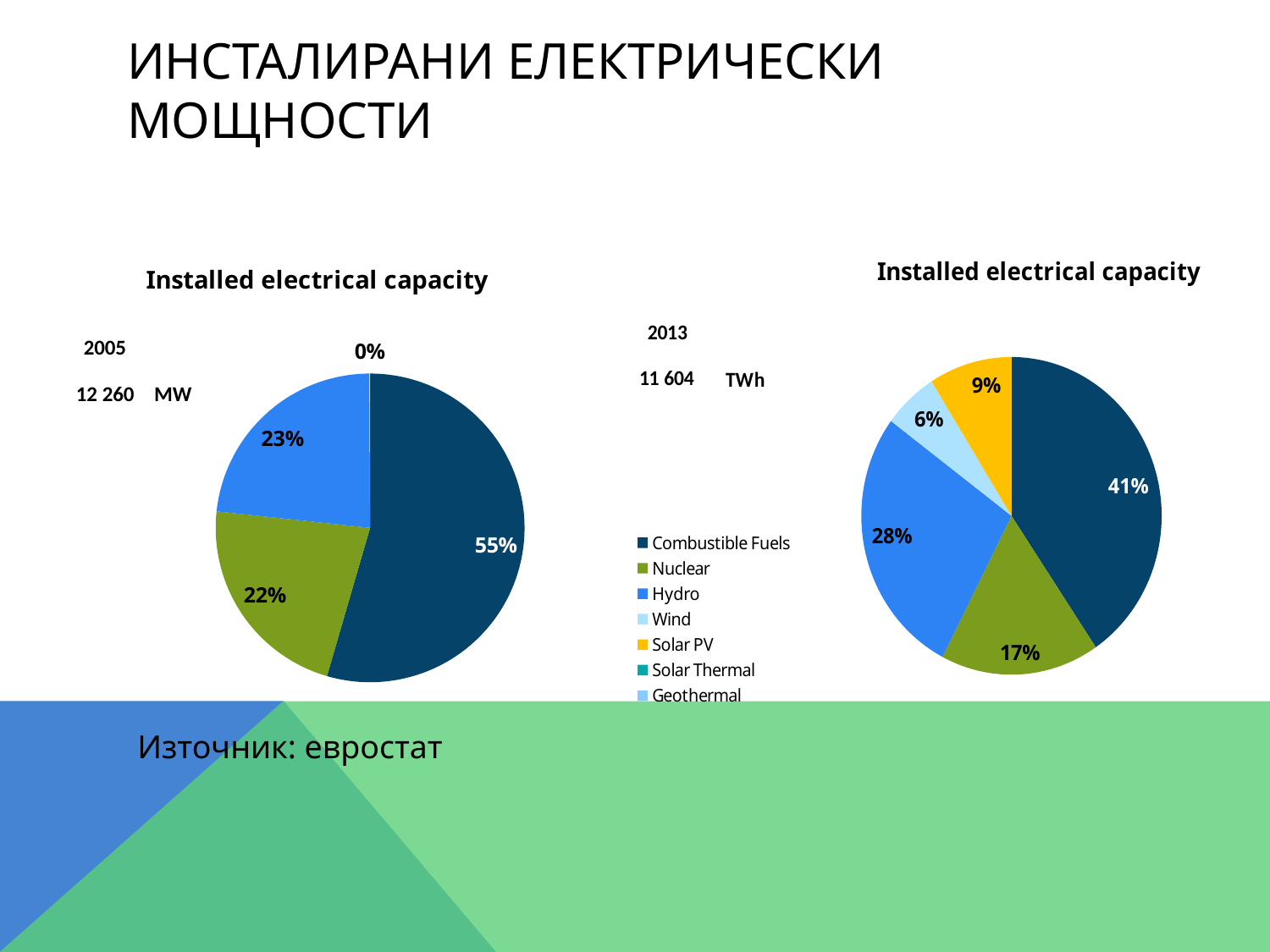
In the right pie chart (2013), what is the difference between the Hydro share and the Nuclear share? 11% In the right pie chart (2013), what share does Hydro have? 28% In the right pie chart (2013), which category has the largest share? Combustible Fuels In the right pie chart (2013), what share does Solar PV have? 9% In the right pie chart (2013), what share does Wind have? 6% In the left pie chart (2005), what share does Nuclear have? 22% In the left pie chart (2005), what share does Combustible Fuels have? 55% In the right pie chart (2013), what share does Combustible Fuels have? 41% In the left pie chart (2005), what share does Hydro have? 23% In the left pie chart (2005), which is larger, the Hydro share or the Nuclear share? Hydro In the right pie chart (2013), which labelled category has the smallest share? Wind What type of chart is used on this slide? Pie chart